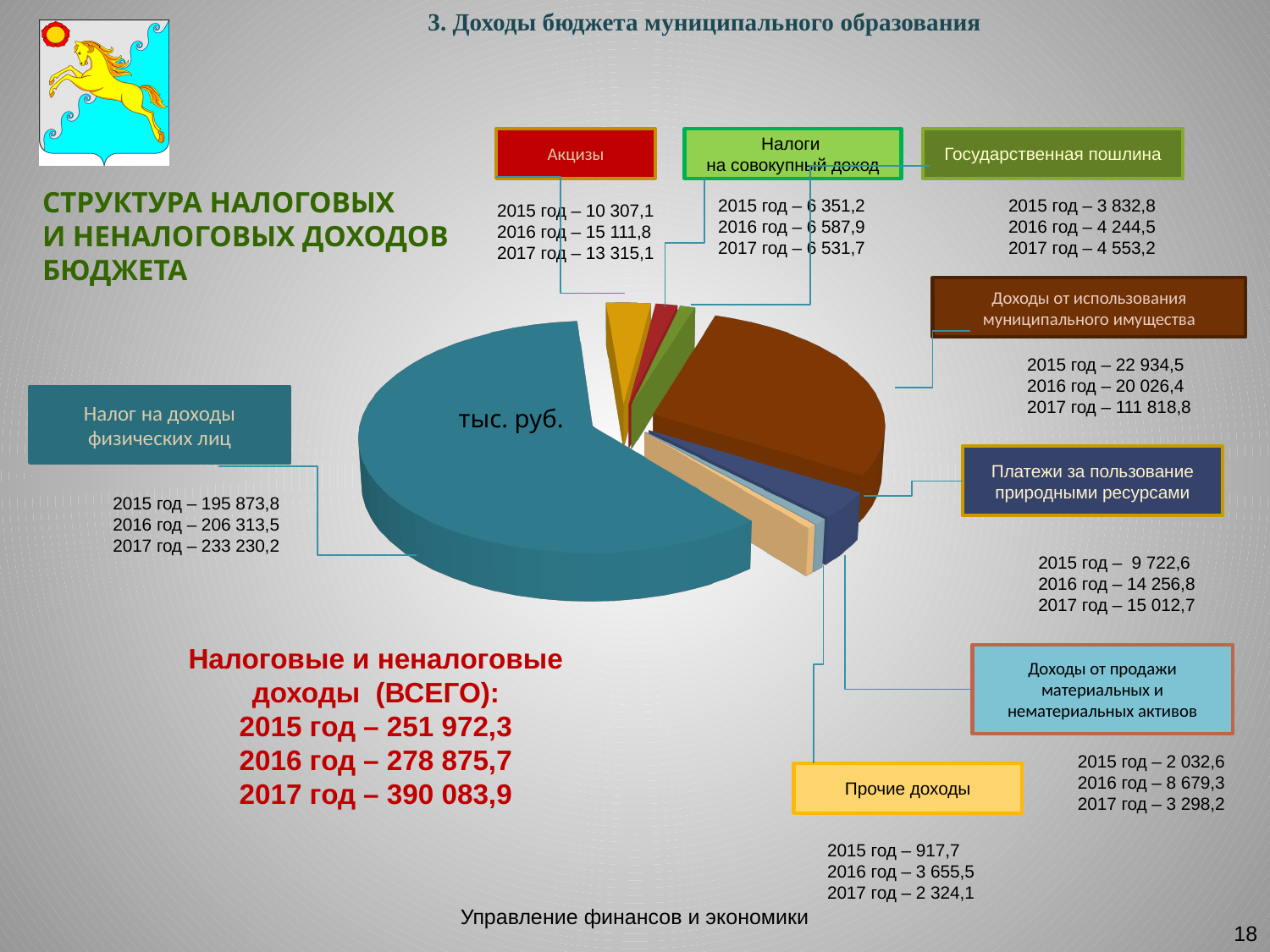
What is the value of Прочие доходы for 2016 год? 3 655,5 What is the value of Государственная пошлина for 2015 год? 3 832,8 What is the value of Доходы от использования муниципального имущества for 2017 год? 111 818,8 What is the total of Налоговые и неналоговые доходы (ВСЕГО) for 2017 год? 390 083,9 What unit label is printed inside the pie chart? тыс. руб. How many categories (slices) does the pie chart have? 8 What kind of chart is shown on the slide? pie chart What is the value of Налог на доходы физических лиц for 2017 год? 233 230,2 Which category has the largest slice of the pie chart? Налог на доходы физических лиц What is the value of Акцизы for 2016 год? 15 111,8 Which is larger for 2017 год: Акцизы or Налоги на совокупный доход? Акцизы By how much did Платежи за пользование природными ресурсами increase from 2015 год to 2017 год? 5 290,1